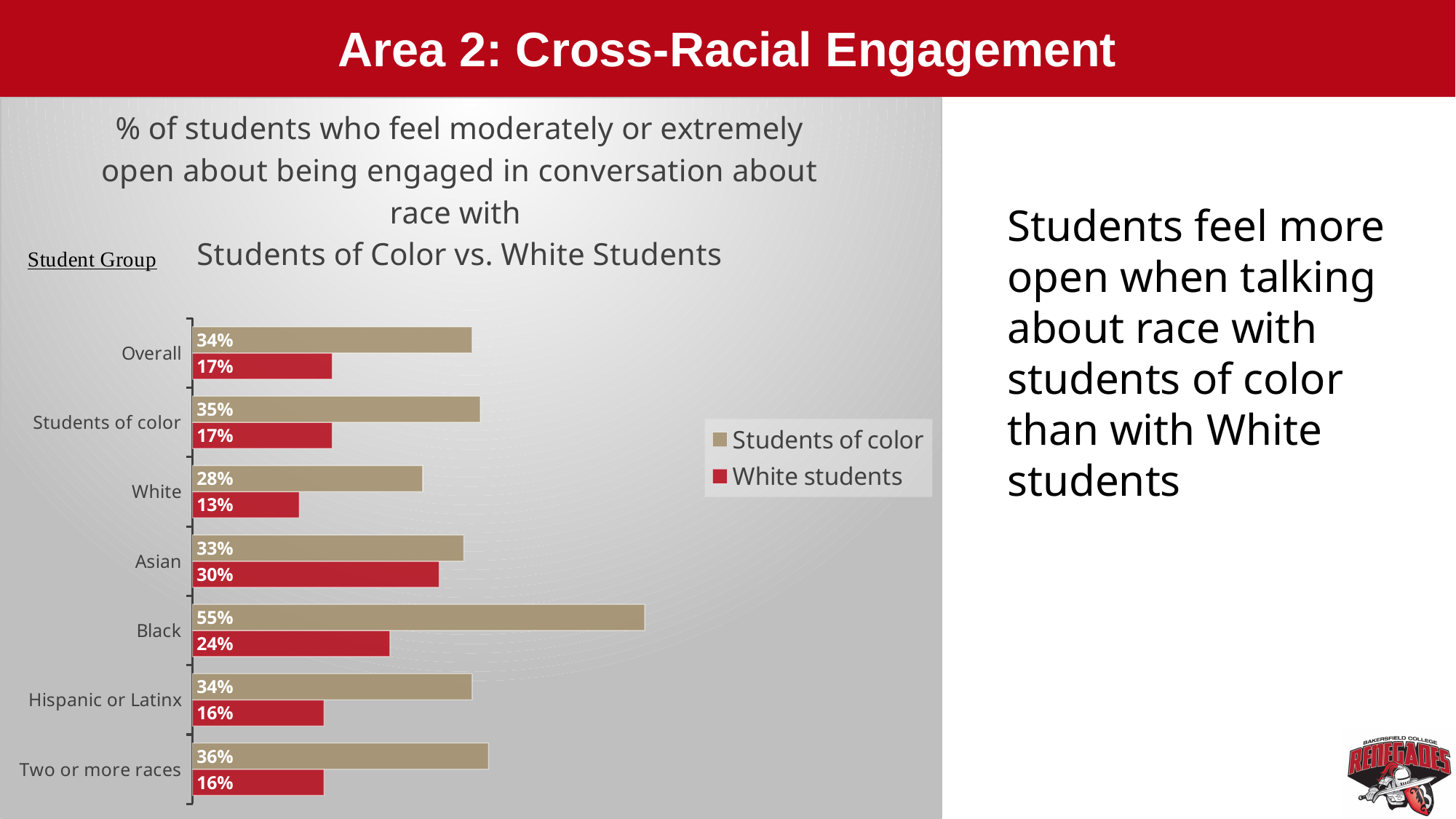
What is the value for Two or more races in the Students of color series? 36% Which colour represents the White students series in the legend? Red What is the value for Black students in the Students of color series? 55% What is the difference between the Students of color and White students values for the Black group? 31% Which student group has the lowest value in the White students series? White What is the value for Asian students in the White students series? 30% How many student groups are shown on the chart? 7 Which student group has the highest value in the Students of color series? Black What is the Overall value for the White students series? 17% What kind of chart is shown on the slide? Bar chart For the Asian group, which series has the larger value: Students of color or White students? Students of color How many series does the legend list? 2